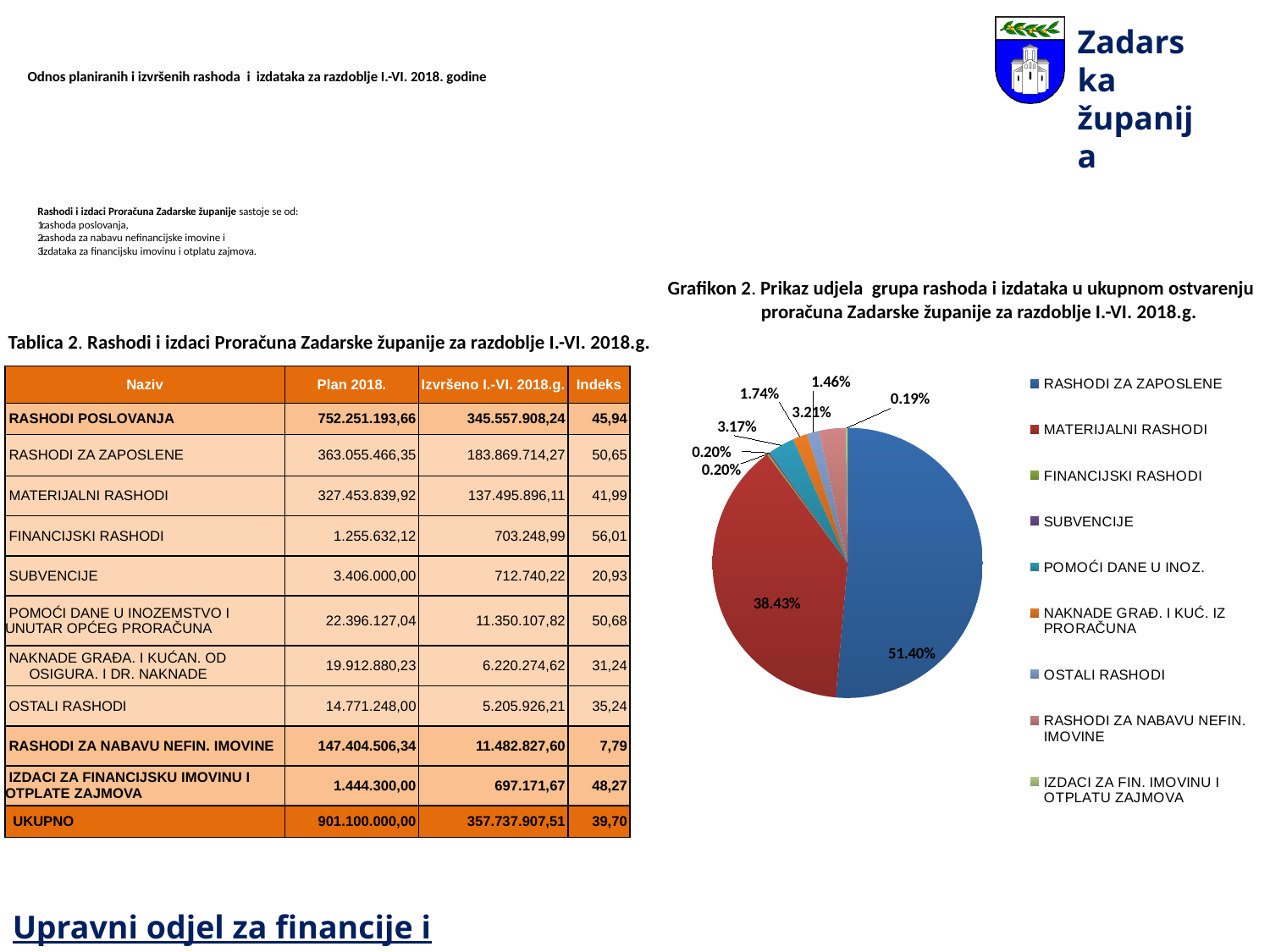
In the pie chart (Grafikon 2), which is larger: RASHODI ZA ZAPOSLENE or MATERIJALNI RASHODI? RASHODI ZA ZAPOSLENE What kind of chart is shown in Grafikon 2? pie chart In the pie chart (Grafikon 2), what share is shown for RASHODI ZA ZAPOSLENE? 51.40% In the pie chart (Grafikon 2), what is the difference in percentage points between RASHODI ZA ZAPOSLENE and MATERIJALNI RASHODI? 12.97% In the pie chart (Grafikon 2), what share is shown for MATERIJALNI RASHODI? 38.43% In the pie chart (Grafikon 2), is the share for RASHODI ZA ZAPOSLENE greater or less than 50%? greater In the pie chart (Grafikon 2), what share is shown for IZDACI ZA FIN. IMOVINU I OTPLATU ZAJMOVA? 0.19% In the pie chart (Grafikon 2), which category has the largest slice? RASHODI ZA ZAPOSLENE In the pie chart (Grafikon 2), what colour is the slice for MATERIJALNI RASHODI? red In the pie chart (Grafikon 2), which category has the smallest slice? IZDACI ZA FIN. IMOVINU I OTPLATU ZAJMOVA How many categories does the legend of the pie chart (Grafikon 2) list? 9